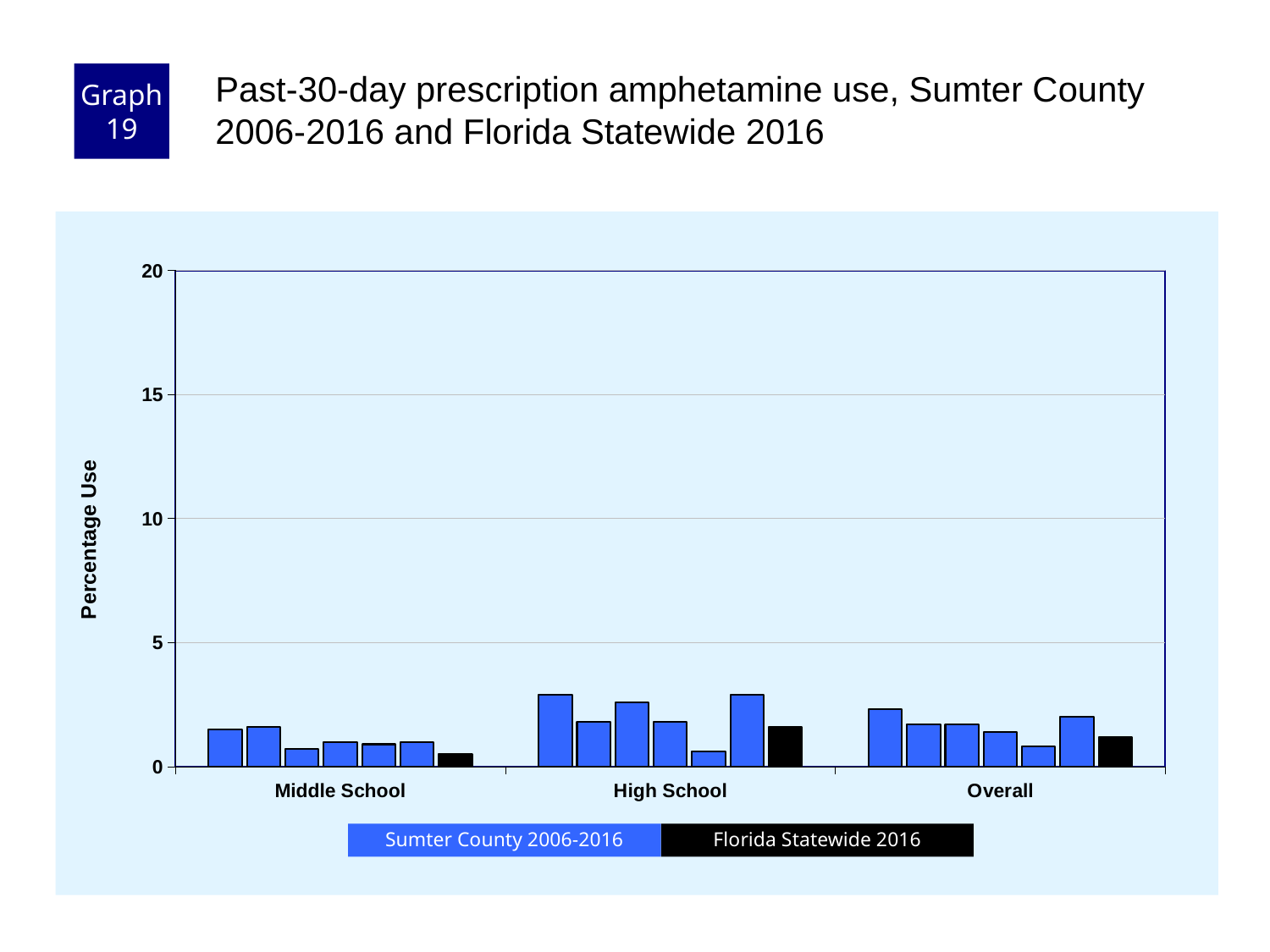
Which category has the lowest Florida Statewide 2016 bar? Middle School Which colour represents Florida Statewide 2016 in the chart? black Which category has the highest Florida Statewide 2016 bar? High School How many series does the chart's legend list? 2 Are any of the bars in the chart greater or less than 10? less Is the Florida Statewide 2016 bar larger for Overall or for Middle School? Overall Is the Florida Statewide 2016 bar larger for High School or for Middle School? High School Is the Florida Statewide 2016 value for Middle School greater or less than 5? less What is the label of the vertical axis? Percentage Use Is the Florida Statewide 2016 value for High School greater or less than 5? less What kind of chart is shown on the slide? bar chart How many categories are shown on the x axis of the chart? 3